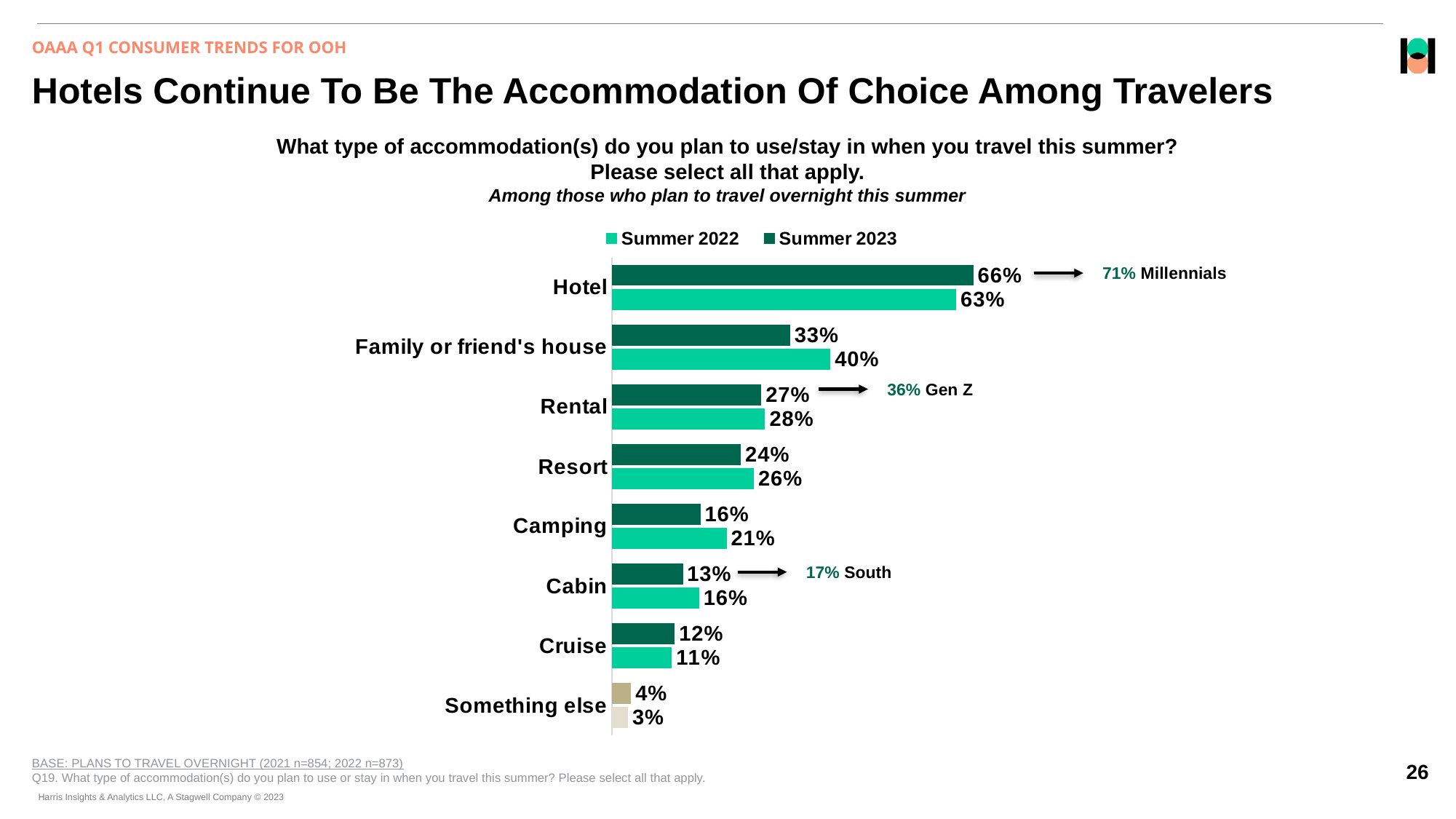
What is the difference between the Summer 2022 and Summer 2023 values for Family or friend's house? 7% How many accommodation categories are shown in the chart? 8 Which is larger for Camping: the Summer 2022 value or the Summer 2023 value? Summer 2022 How many series does the legend list? 2 What percentage of travelers planned to stay in a hotel in Summer 2023? 66% What percentage of Gen Z is noted next to the Rental bar? 36% Which accommodation type has the lowest Summer 2022 value? Something else What kind of chart is shown on the slide? Bar chart By how many percentage points did the Hotel value increase from Summer 2022 to Summer 2023? 3% What is the Summer 2022 value for Family or friend's house? 40% What is the Summer 2023 value for Camping? 16% Which accommodation type has the highest Summer 2023 value? Hotel